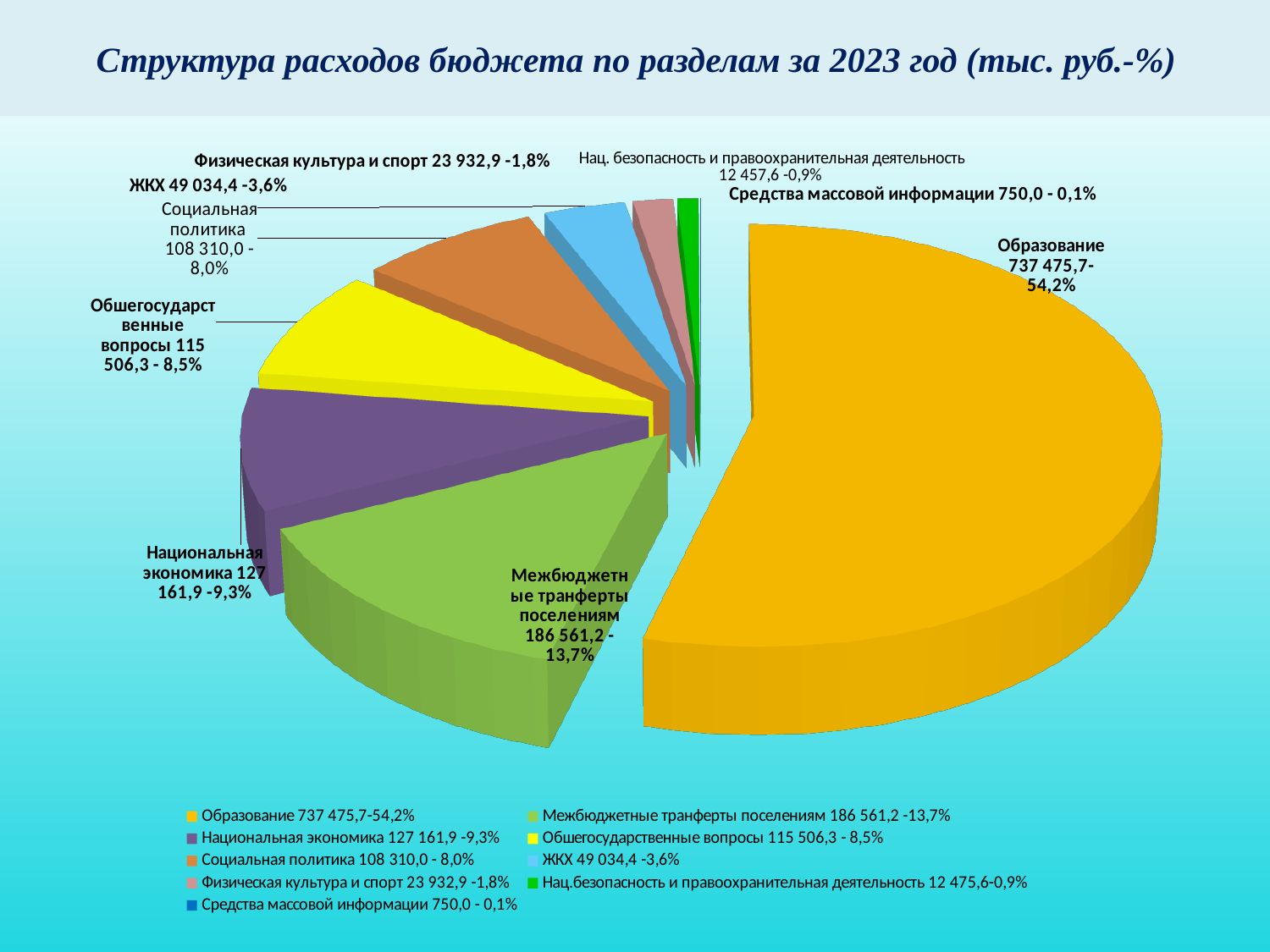
What is the difference in percentage points between Образование and Межбюджетные трансферты поселениям? 40,5 Which section has the largest share of budget expenditures? Образование What is the title of the chart on the slide? Структура расходов бюджета по разделам за 2023 год (тыс. руб.-%) What is the value in thousand rubles for Межбюджетные трансферты поселениям? 186 561,2 Which is larger: the share for ЖКХ or the share for Физическая культура и спорт? ЖКХ What percentage share is shown for Национальная экономика? 9,3% How many sections (slices) does the pie chart contain? 9 What share of budget expenditures does Образование account for? 54,2% What is the value in thousand rubles for Социальная политика? 108 310,0 Which section has the smallest share of budget expenditures? Средства массовой информации What is the difference in percentage points between Национальная экономика and Общегосударственные вопросы? 0,8 What type of chart is shown on the slide? Pie chart